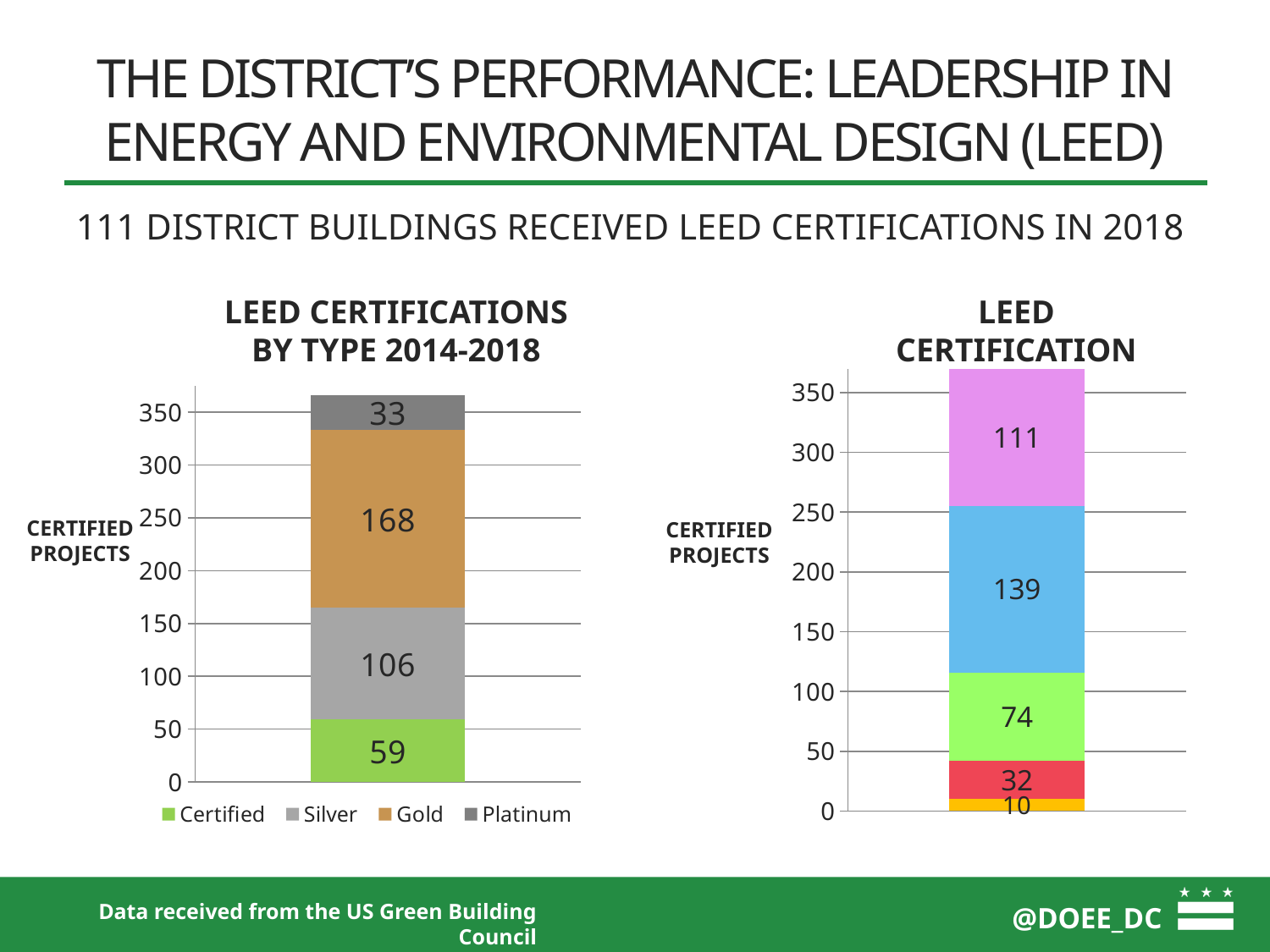
In the chart titled "LEED CERTIFICATIONS BY TYPE 2014-2018", what is the difference between the Gold and Silver values? 62 In the chart titled "LEED CERTIFICATIONS BY TYPE 2014-2018", how many certified projects are in the Gold segment? 168 In the chart titled "LEED CERTIFICATIONS BY TYPE 2014-2018", which certification type has the lowest number of certified projects? Platinum In the chart titled "LEED CERTIFICATIONS BY TYPE 2014-2018", what is the value for Platinum? 33 In the chart titled "LEED CERTIFICATIONS BY TYPE 2014-2018", what is the value for Silver? 106 In the chart titled "LEED CERTIFICATIONS BY TYPE 2014-2018", how many series does the legend list? 4 In the chart titled "LEED CERTIFICATIONS BY TYPE 2014-2018", which is larger, Certified or Silver? Silver In the chart titled "LEED CERTIFICATIONS BY TYPE 2014-2018", which certification type has the highest number of certified projects? Gold In the chart titled "LEED CERTIFICATION" on the right, how many segments make up the stacked bar? 5 In the chart titled "LEED CERTIFICATION" on the right, what is the total of all the segments in the stacked bar? 366 In the chart titled "LEED CERTIFICATIONS BY TYPE 2014-2018", what is the total of the stacked bar? 366 What kind of chart is the chart titled "LEED CERTIFICATION" on the right of the slide? Stacked bar chart